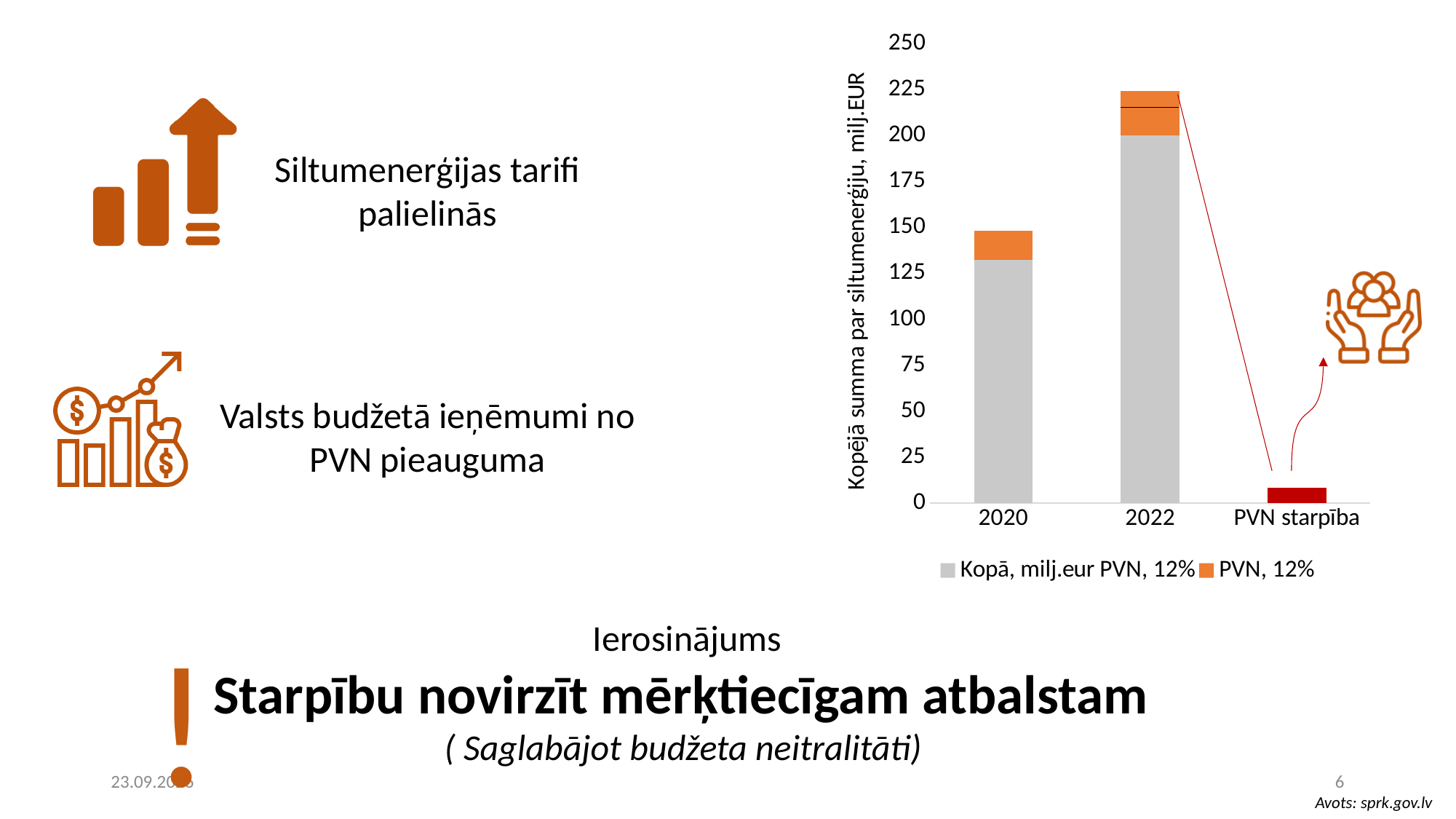
Which series is shown in orange in the chart legend? PVN, 12% How many categories are shown on the x axis of the chart? 3 Does the total amount rise or fall from 2020 to 2022? Rise How many series does the chart legend list? 2 What is the title of the vertical axis of the chart? Kopējā summa par siltumenerģiju, milj.EUR What kind of chart is shown on the slide? Stacked bar chart Which category has the tallest bar in the chart? 2022 Is the total value for 2020 greater or less than 125? greater Is the total bar for 2022 taller or shorter than the total bar for 2020? Taller Is the value for PVN starpība greater or less than 25? less Which category has the shortest bar in the chart? PVN starpība Is the total value for 2022 greater or less than 200? greater